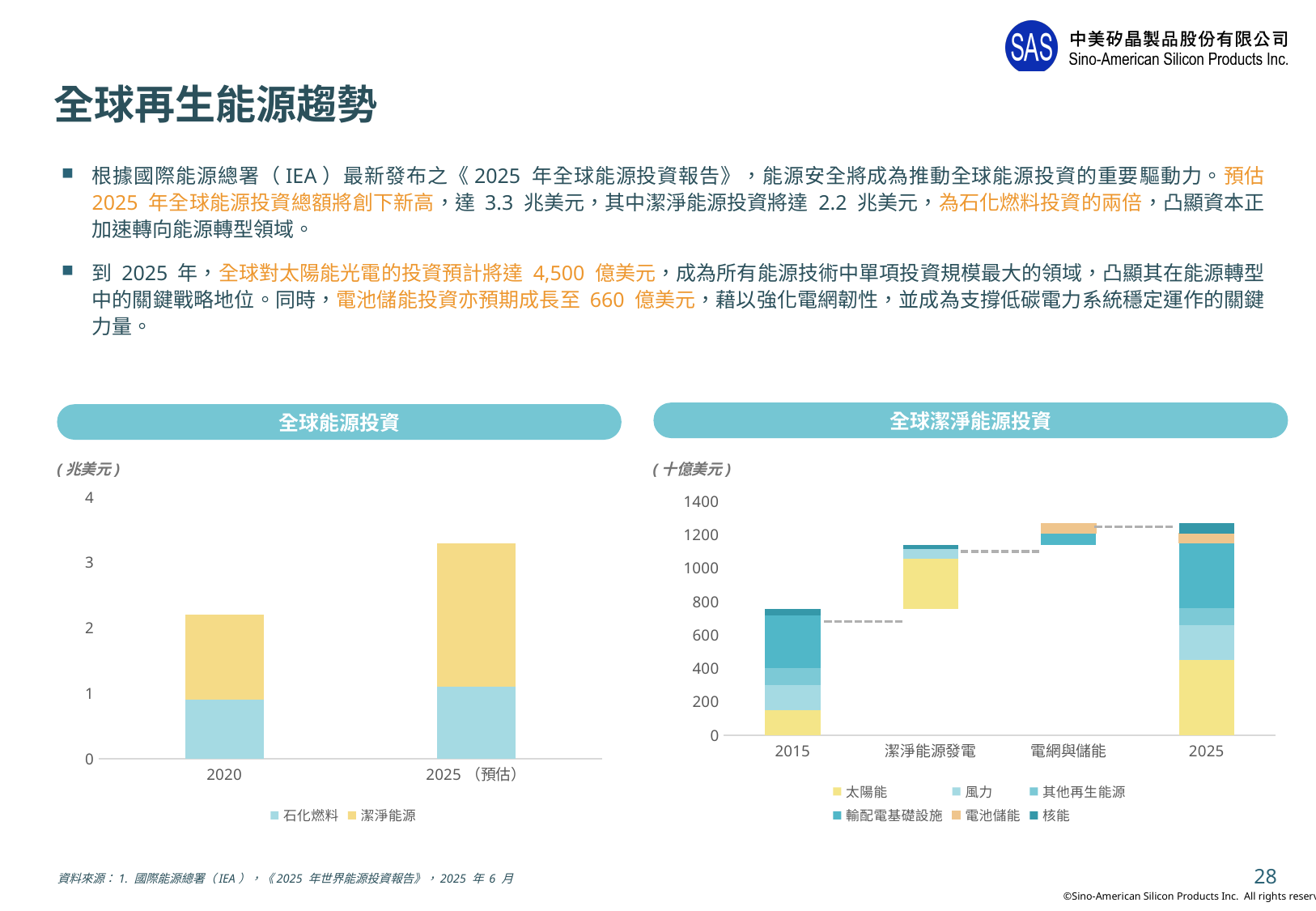
In the 全球能源投資 chart, is the total bar for 2025 (預估) greater or less than 3? greater In the 全球潔淨能源投資 chart, is the total bar for 2025 greater or less than 1200? greater In the 全球潔淨能源投資 chart, is the total bar for 2015 greater or less than 800? less What type of chart is the 全球能源投資 chart on the left? bar chart In the 全球能源投資 chart, which year has the taller total bar, 2020 or 2025 (預估)? 2025 (預估) How many categories are shown on the x axis of the 全球潔淨能源投資 chart? 4 How many series does the legend of the 全球潔淨能源投資 chart list? 6 What unit is shown for the 全球能源投資 chart? 兆美元 How many series does the legend of the 全球能源投資 chart list? 2 How many categories are shown on the x axis of the 全球能源投資 chart? 2